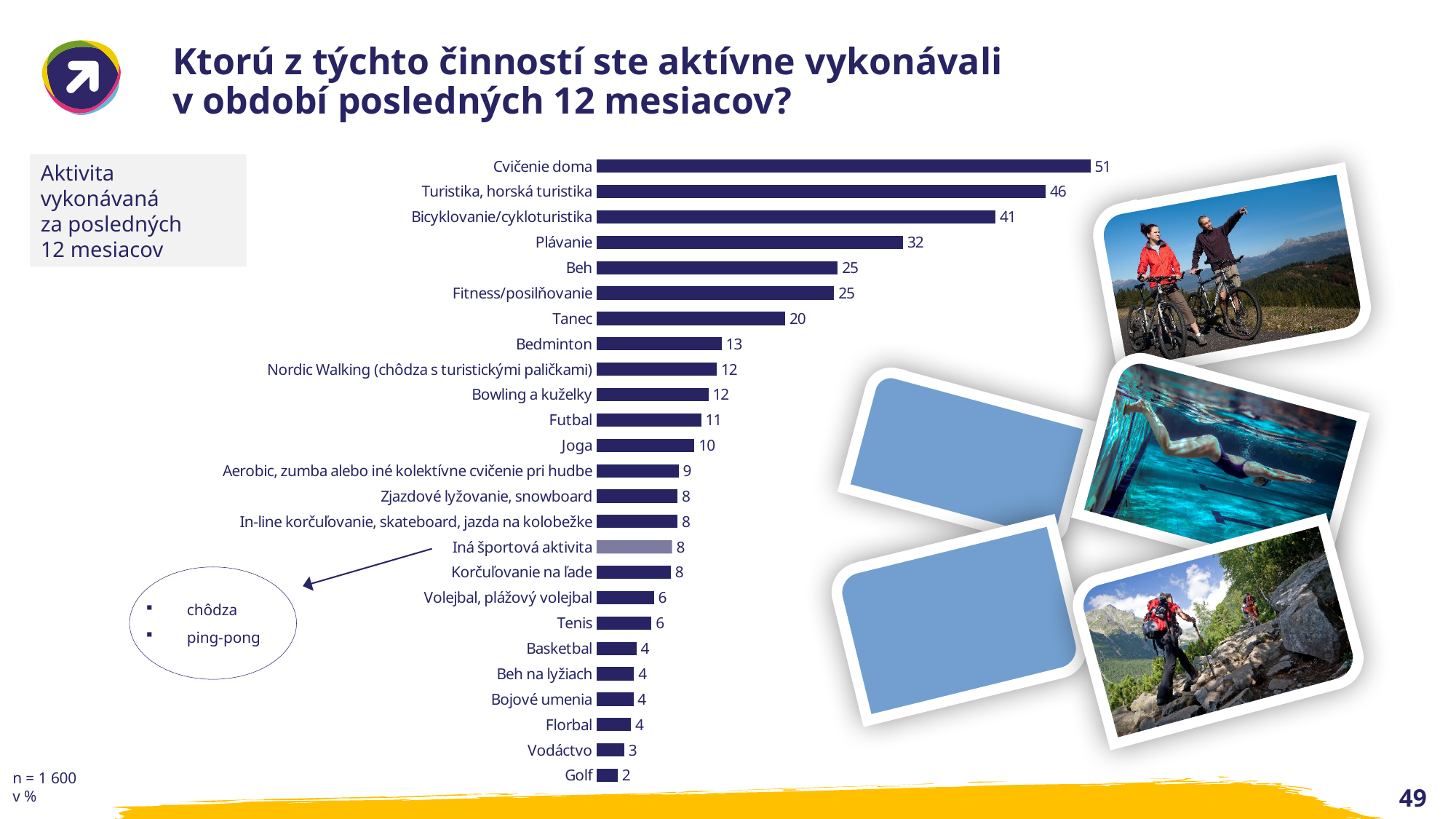
Which activity has the lowest value? Golf Which has a larger value, Joga or Futbal? Futbal What is the difference between the values for Turistika, horská turistika and Bicyklovanie/cykloturistika? 5 What value is shown for Plávanie? 32 Which activity has the highest value? Cvičenie doma Which bar is drawn in a lighter colour than the others? Iná športová aktivita How many activities are plotted in the chart? 25 What value is shown for Cvičenie doma? 51 Which has a larger value, Tenis or Basketbal? Tenis What value is shown for Nordic Walking (chôdza s turistickými paličkami)? 12 What is the difference between the values for Tanec and Bedminton? 7 What kind of chart is shown on the slide? Bar chart